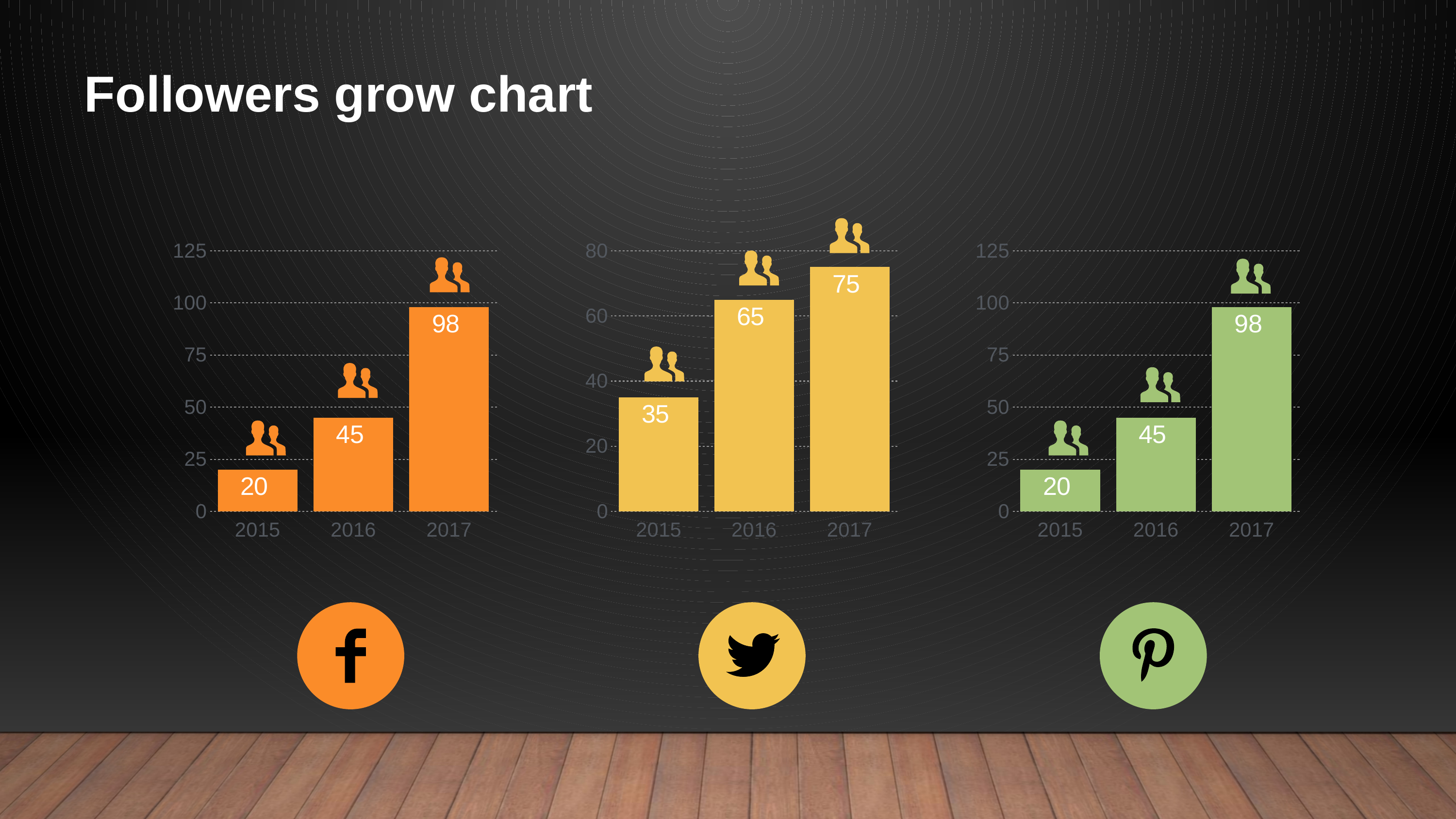
In the right (Pinterest) chart, what is the value for 2016? 45 In the middle (Twitter) chart, what is the difference between the 2017 and 2016 values? 10 In the left (Facebook) chart, which year has the lowest value? 2015 In the left (Facebook) chart, is the value for 2016 greater or less than 50? less In the right (Pinterest) chart, what is the difference between the 2017 and 2015 values? 78 In the left (Facebook) chart, what is the value for 2017? 98 What kind of chart is the middle (Twitter) chart? bar chart In the middle (Twitter) chart, which year has the highest value? 2017 In the middle (Twitter) chart, what is the value for 2015? 35 In the left (Facebook) chart, do the values rise or fall from 2015 to 2017? rise How many years are shown on the x axis of the right (Pinterest) chart? 3 In the middle (Twitter) chart, which is larger, the value for 2016 or the value for 2015? 2016